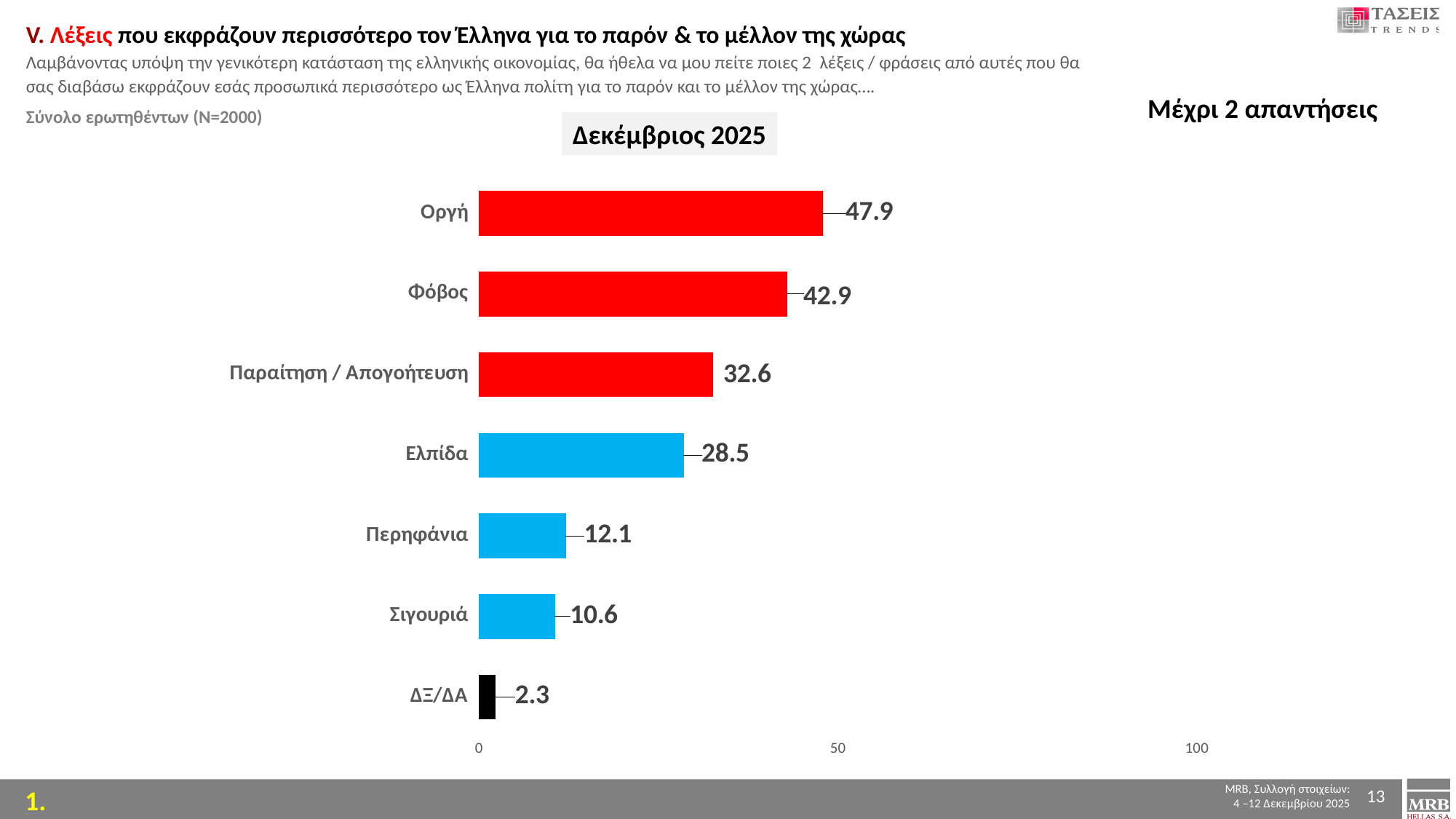
What is the difference between the values for Οργή and Φόβος? 5.0 What is the value for Σιγουριά? 10.6 Is the value for Φόβος greater or less than 50? less What is the difference between the values for Περηφάνια and Σιγουριά? 1.5 What is the value for Οργή? 47.9 What is the title shown above the chart? Δεκέμβριος 2025 How many categories are shown in the chart? 7 Which category has the highest value? Οργή What is the value for Ελπίδα? 28.5 What kind of chart is shown on the slide? bar chart Which category has the lowest value? ΔΞ/ΔΑ Which is larger, the value for Παραίτηση / Απογοήτευση or the value for Ελπίδα? Παραίτηση / Απογοήτευση